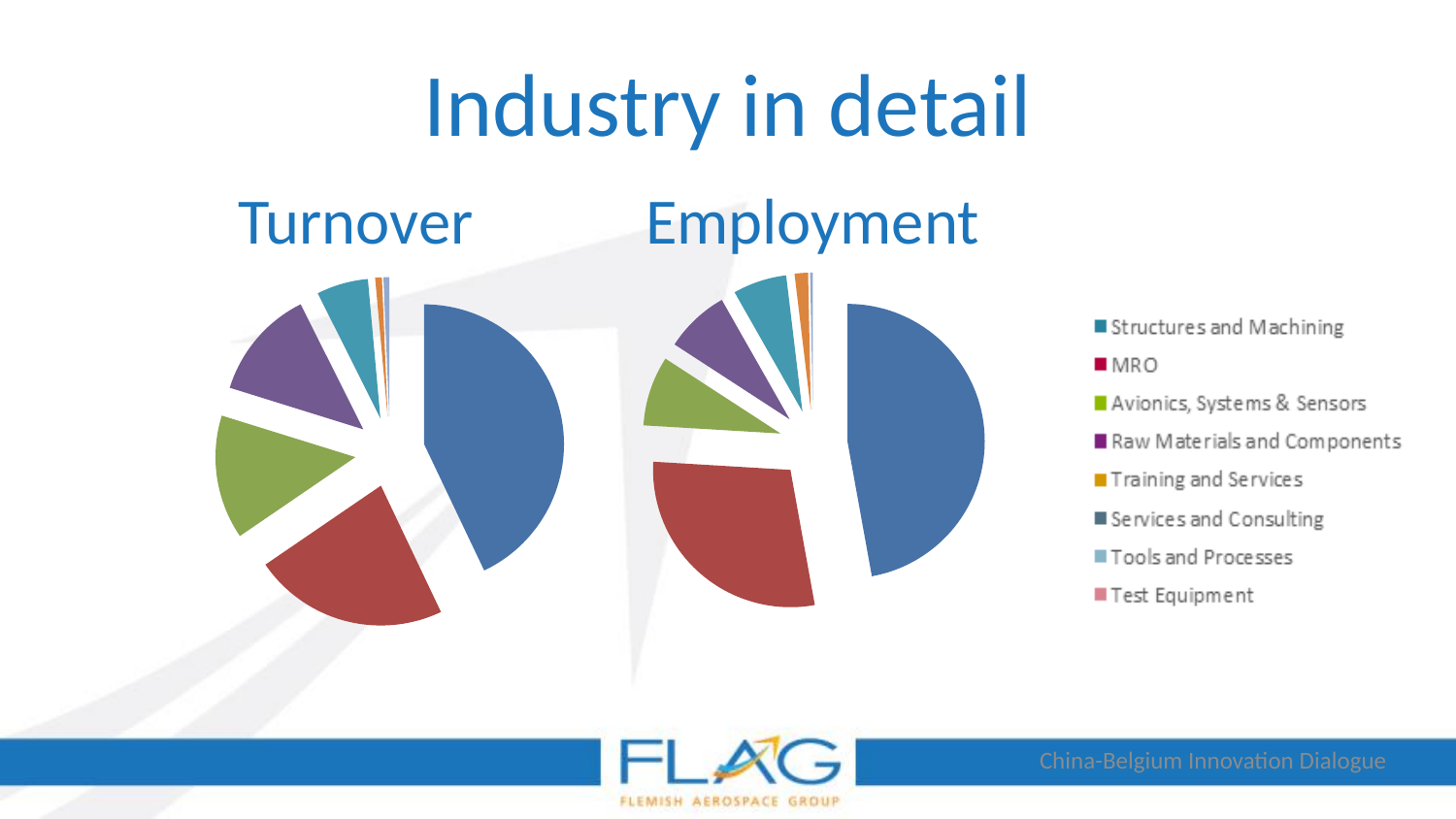
What is the title of the slide containing the two pie charts? Industry in detail In the Employment pie chart, which category has the largest slice? Structures and Machining In the Turnover pie chart, which slice is larger: MRO or Avionics, Systems & Sensors? MRO In the Employment pie chart, which slice is larger: MRO or Raw Materials and Components? MRO In the Employment pie chart, which slice is larger: Structures and Machining or MRO? Structures and Machining What kind of chart is used for the Turnover data? Pie chart How many categories does the legend list? 8 In the Turnover pie chart, which category has the largest slice? Structures and Machining What kind of chart is used for the Employment data? Pie chart How many charts are shown on the slide? 2 Which legend entry is listed first? Structures and Machining